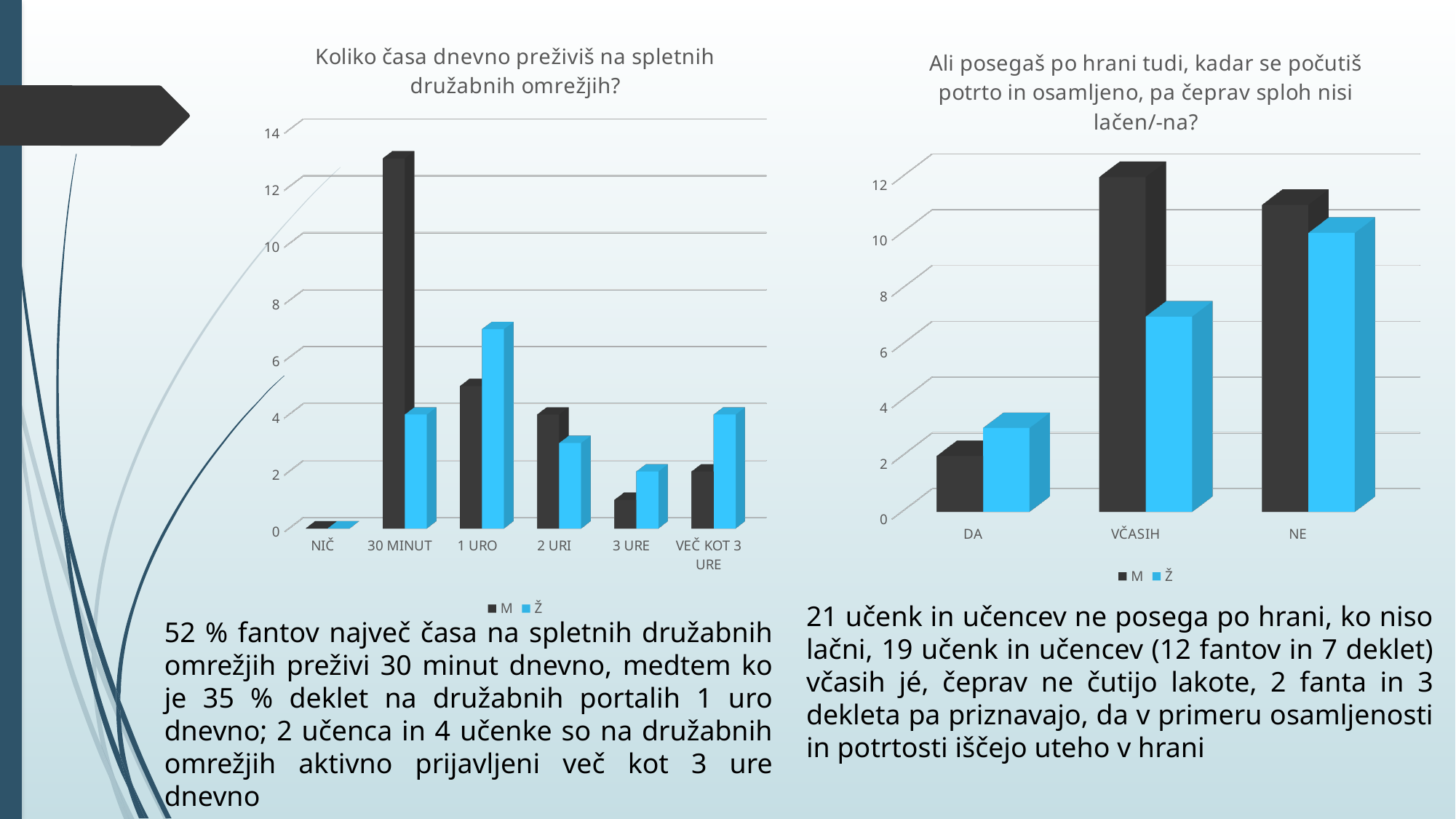
In the left chart ("Koliko časa dnevno preživiš..."), which category has the lowest value for series Ž? NIČ In the left chart ("Koliko časa dnevno preživiš..."), is the value for Ž at 3 URE greater or less than 4? less In the right chart ("Ali posegaš po hrani..."), which is larger at DA, M or Ž? Ž In the left chart ("Koliko časa dnevno preživiš..."), is the value for M at 30 MINUT greater or less than 12? greater What are the two legend entries of the left chart ("Koliko časa dnevno preživiš...")? M and Ž How many categories are shown on the x axis of the left chart ("Koliko časa dnevno preživiš na spletnih družabnih omrežjih?")? 6 In the right chart ("Ali posegaš po hrani..."), is the value for Ž at VČASIH greater or less than 10? less In the left chart ("Koliko časa dnevno preživiš..."), which is larger at 1 URO, M or Ž? Ž In the right chart ("Ali posegaš po hrani..."), which category has the highest value for series M? VČASIH In the left chart ("Koliko časa dnevno preživiš..."), which category has the highest value for series M? 30 MINUT What kind of chart is the left chart titled "Koliko časa dnevno preživiš na spletnih družabnih omrežjih?"? bar chart How many series does the legend of the right chart ("Ali posegaš po hrani...") list? 2